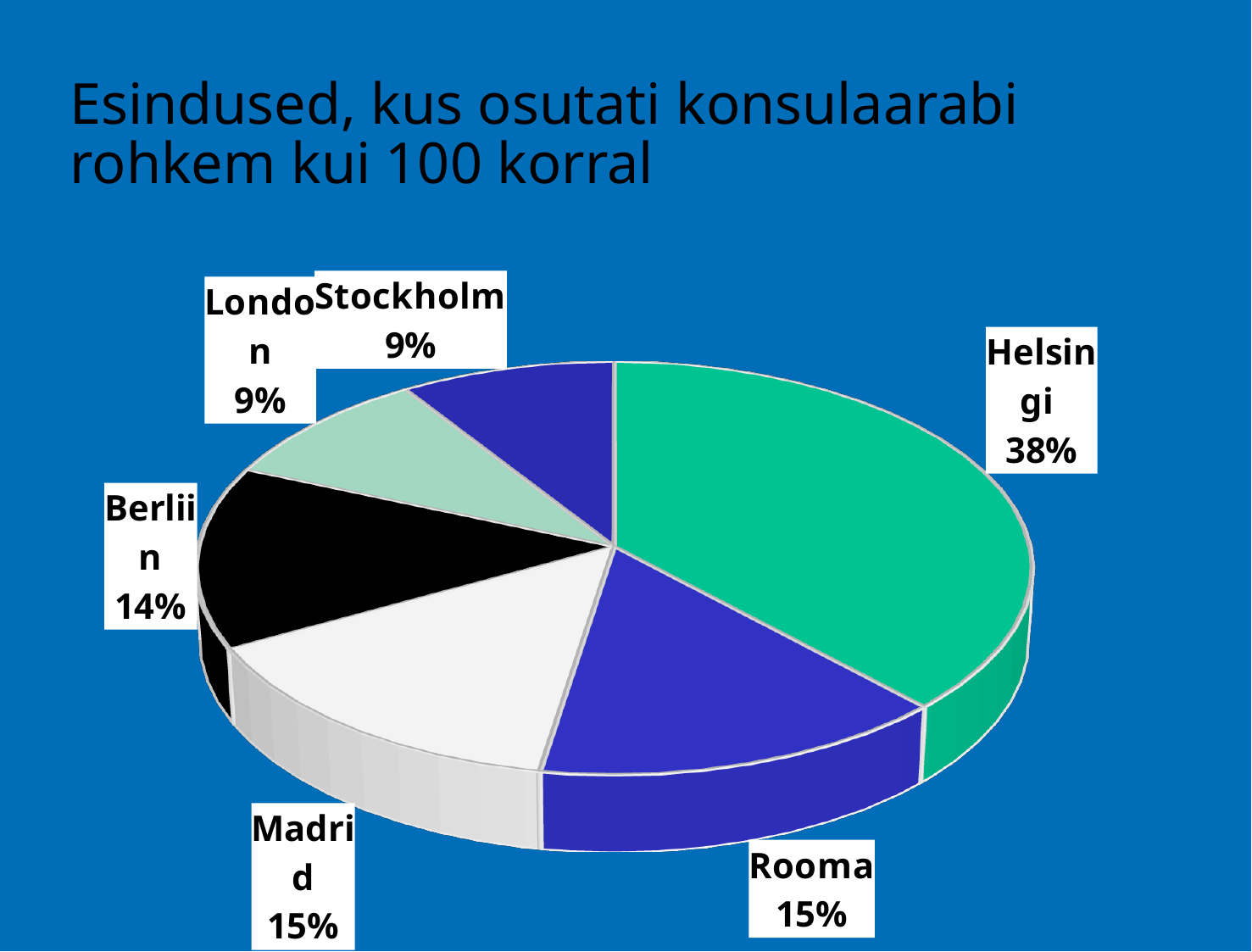
What is the value labelled for Rooma? 15% What is the difference in percentage points between Berliin and London? 5 What is the title of the slide? Esindused, kus osutati konsulaarabi rohkem kui 100 korral What percentage is shown for Berliin? 14% Which is larger, the share for Madrid or the share for Berliin? Madrid Which is larger, the share for Helsingi or the share for Stockholm? Helsingi What is the difference in percentage points between Helsingi and Rooma? 23 What type of chart is shown on the slide? Pie chart What share of the pie does Helsingi have? 38% How many cities are shown in the pie chart? 6 What percentage is shown for Stockholm? 9% Which city has the largest slice of the pie? Helsingi